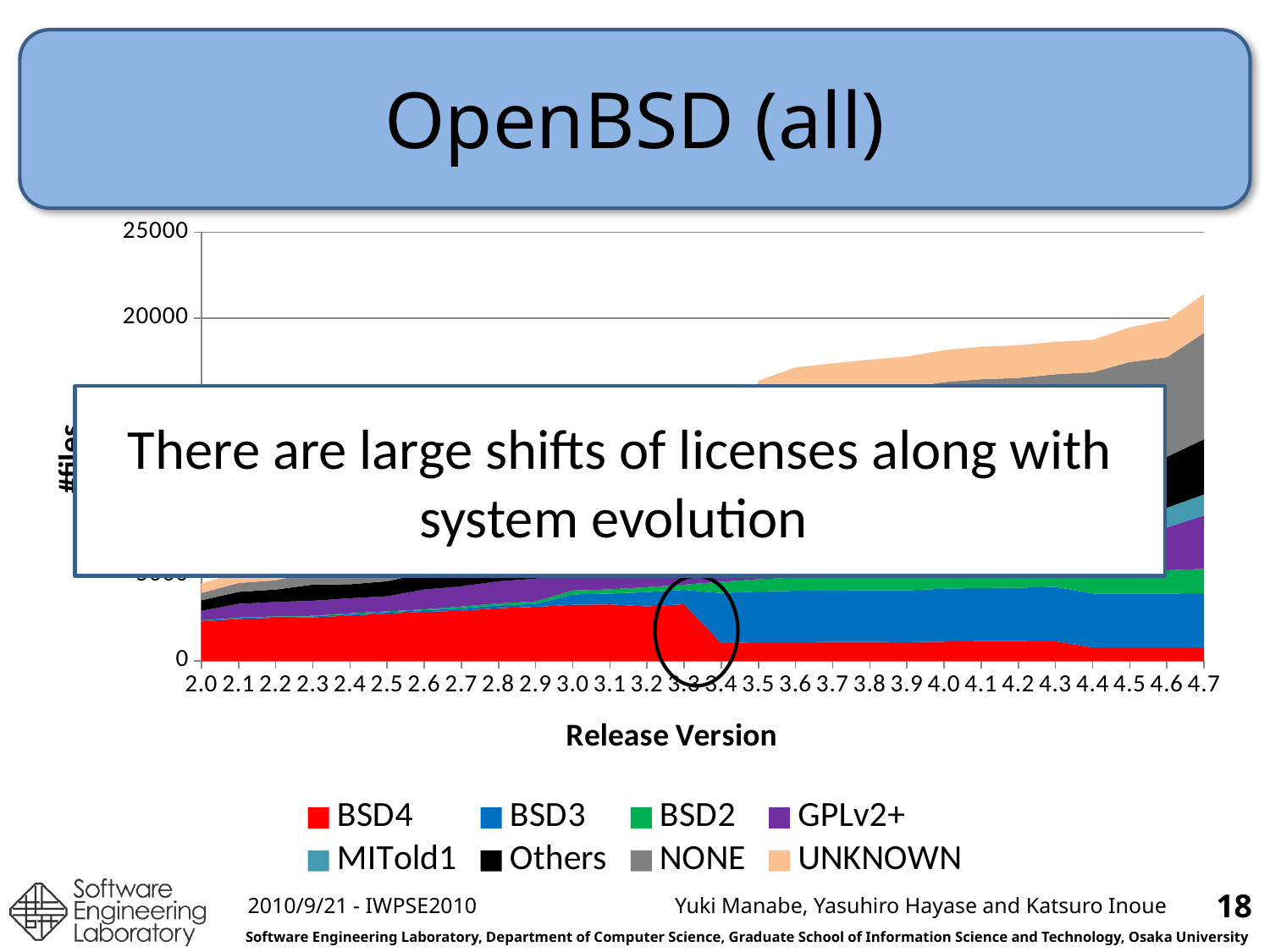
How many release versions are shown along the x axis? 28 Which release version has the lowest total number of files? 2.0 Is the number of BSD3 files larger at release 3.3 or at release 3.4? 3.4 Does the total number of files rise or fall as the release version increases from 2.0 to 4.7? rise Which colour represents BSD4 in the legend? red Which release version has the highest total number of files? 4.7 Is the total number of files at release 4.7 greater or less than 20000? greater What is the title of the x axis? Release Version Is the number of BSD4 files at release 3.3 greater or less than 5000? less Is the number of BSD4 files larger at release 3.3 or at release 3.4? 3.3 How many series does the legend list? 8 What kind of chart is shown on the slide? stacked area chart